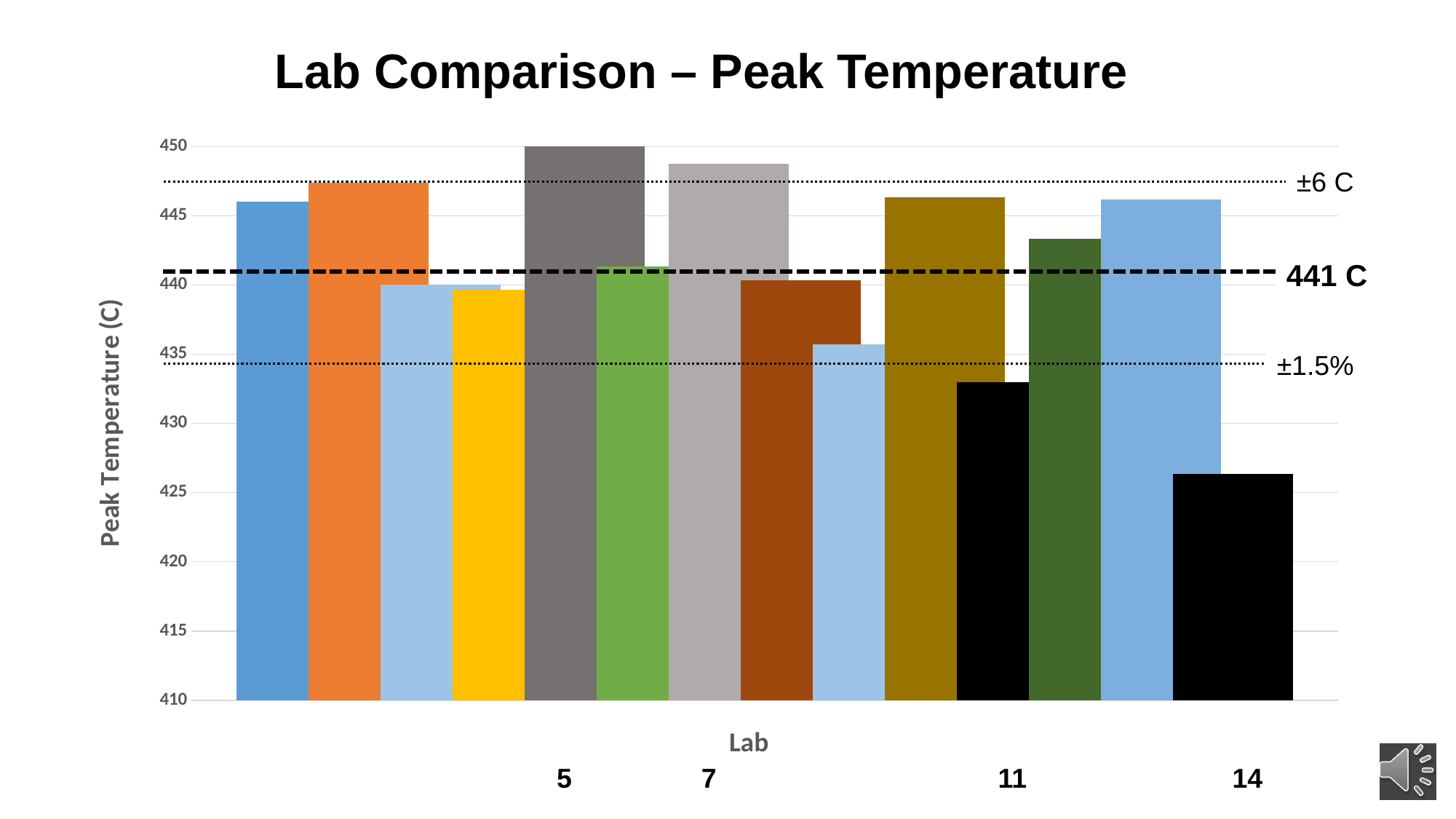
How many bars are plotted in the chart? 14 What value is marked by the bold dashed horizontal reference line? 441 C Is the peak temperature for Lab 14 greater or less than 430? less Which lab has the lowest peak temperature? Lab 14 What is the title of the chart? Lab Comparison – Peak Temperature Is the peak temperature for Lab 5 greater or less than 445? greater What is the label of the vertical axis? Peak Temperature (C) Is the peak temperature for Lab 11 greater or less than 435? less Which has the higher peak temperature, Lab 7 or Lab 11? Lab 7 Which lab has the highest peak temperature? Lab 5 What kind of chart is shown on the slide? bar chart